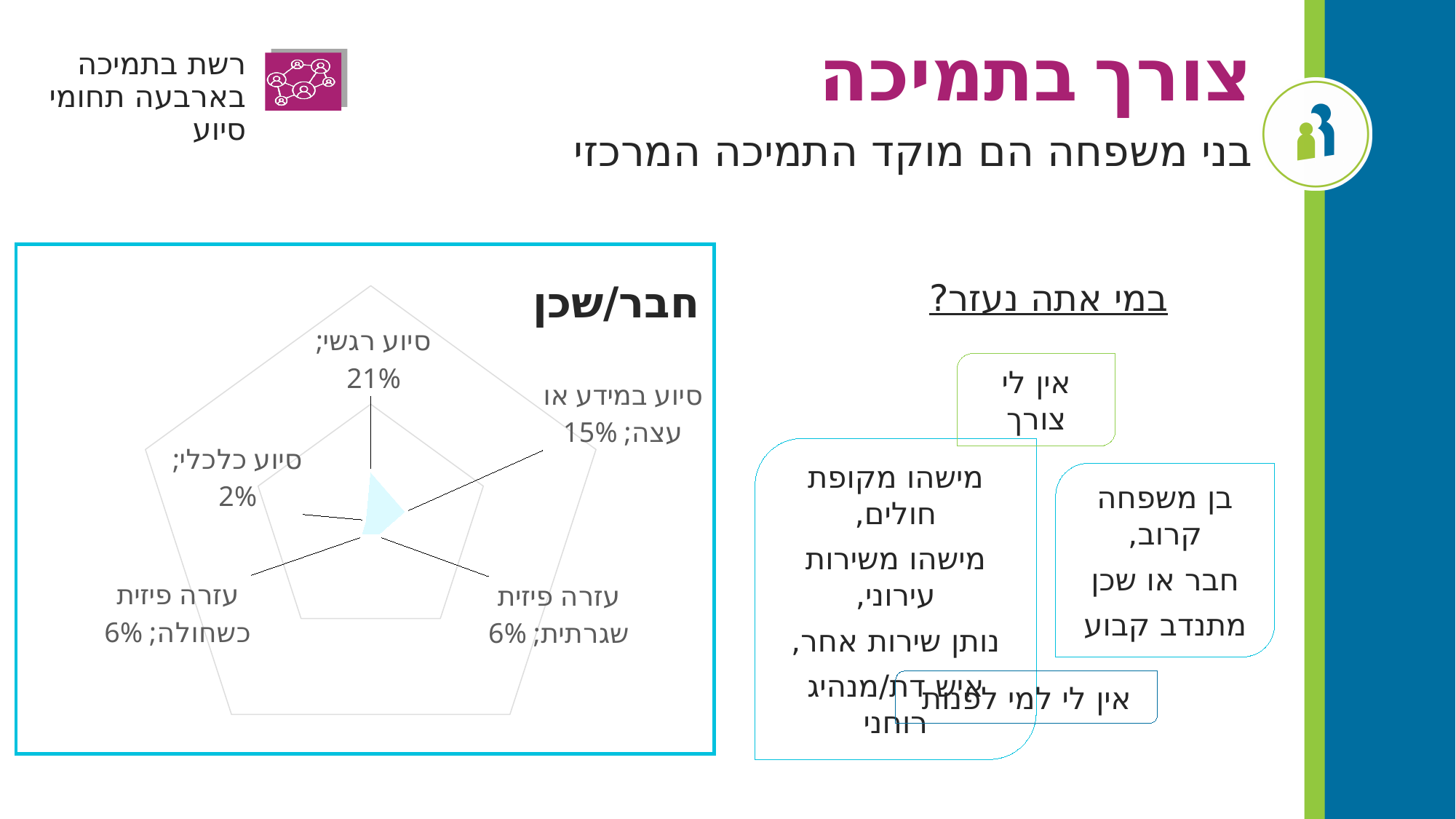
Which category has the lowest value in the chart? סיוע כלכלי What is the value for סיוע במידע או עצה in the chart? 15% What is the value for עזרה פיזית שגרתית in the chart? 6% What kind of chart is shown on the slide? radar chart How many categories does the radar chart have? 5 What is the value for סיוע רגשי in the chart? 21% Which category has the highest value in the chart? סיוע רגשי Which is larger, the value for סיוע במידע או עצה or the value for עזרה פיזית שגרתית? סיוע במידע או עצה What is the title of the chart on the slide? חבר/שכן What is the difference between the values for סיוע רגשי and סיוע במידע או עצה? 6% What is the value for סיוע כלכלי in the chart? 2% What is the value for עזרה פיזית כשחולה in the chart? 6%